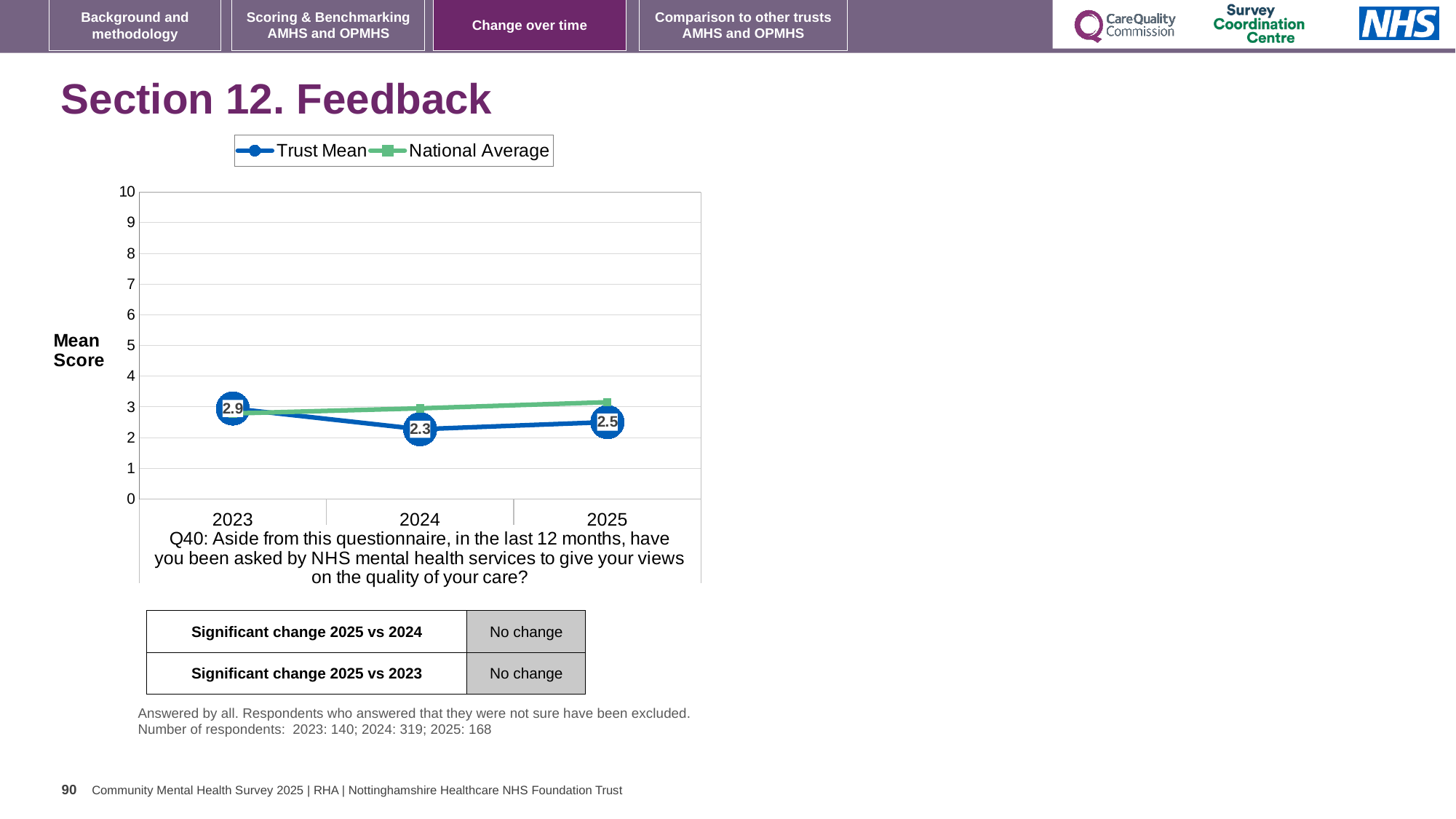
What is the Trust Mean value for 2025? 2.5 In which year is the Trust Mean lowest? 2024 In which year is the Trust Mean highest? 2023 What is the Trust Mean value for 2023? 2.9 What is the Trust Mean value for 2024? 2.3 In 2025, which is larger: the Trust Mean or the National Average? National Average How many series does the legend list? 2 Is the National Average value for 2025 greater or less than 4? less What kind of chart is shown on the slide? line chart What is the difference between the Trust Mean in 2023 and in 2024? 0.6 How many years are plotted on the x axis? 3 Did the Trust Mean rise or fall from 2023 to 2024? fall